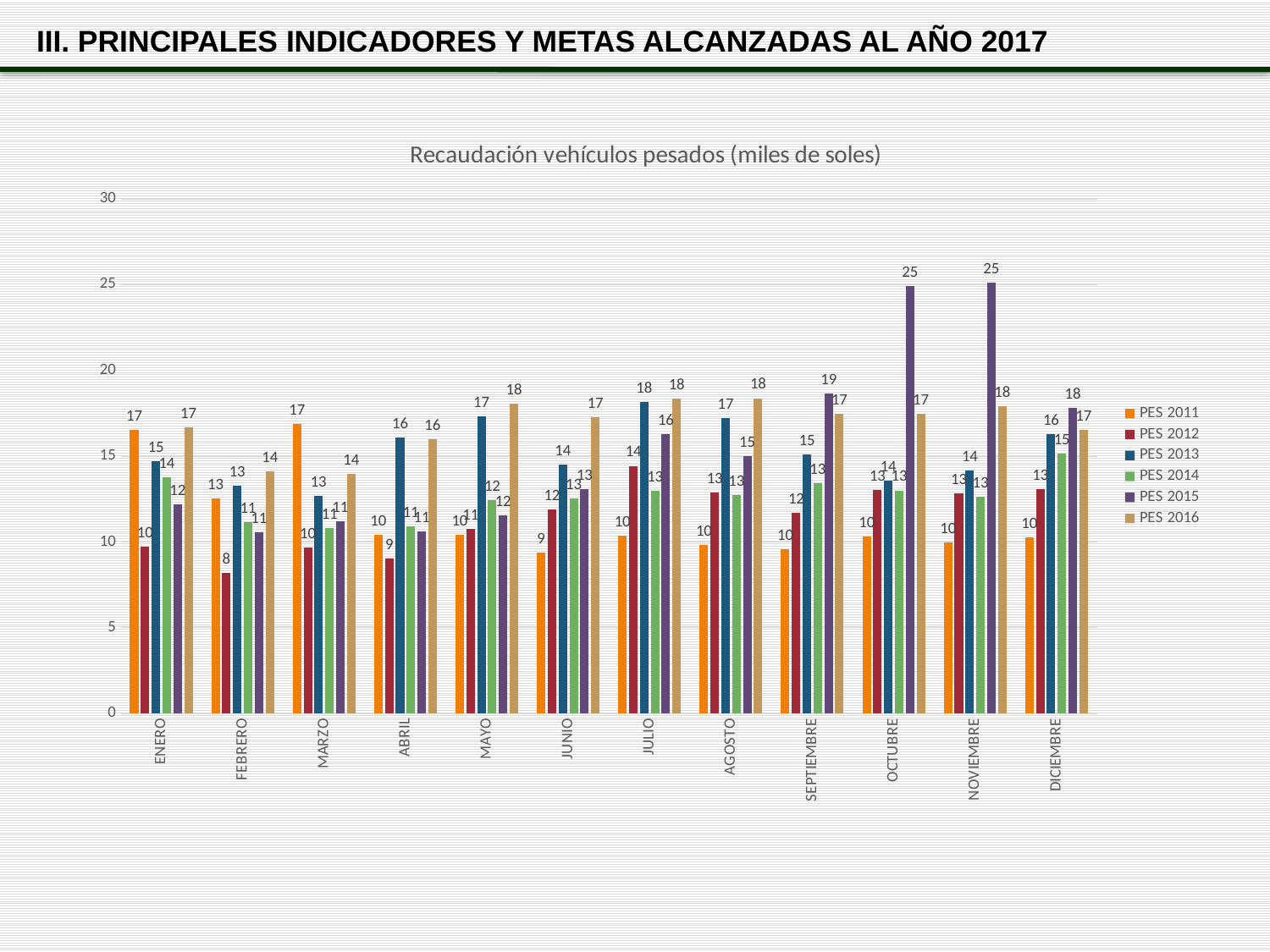
What is the value for PES 2013 in JULIO? 18 What is the difference between PES 2015 and PES 2011 in OCTUBRE? 15 Is the value for PES 2015 in NOVIEMBRE greater or less than 20? greater How many series does the legend list? 6 What is the value for PES 2015 in OCTUBRE? 25 How many months are shown on the x axis? 12 Which is larger in ABRIL, PES 2013 or PES 2014? PES 2013 Which series has the highest value in OCTUBRE? PES 2015 What is the title of the chart? Recaudación vehículos pesados (miles de soles) What kind of chart is shown on the slide? bar chart Which series has the lowest value in FEBRERO? PES 2012 What is the value for PES 2012 in FEBRERO? 8